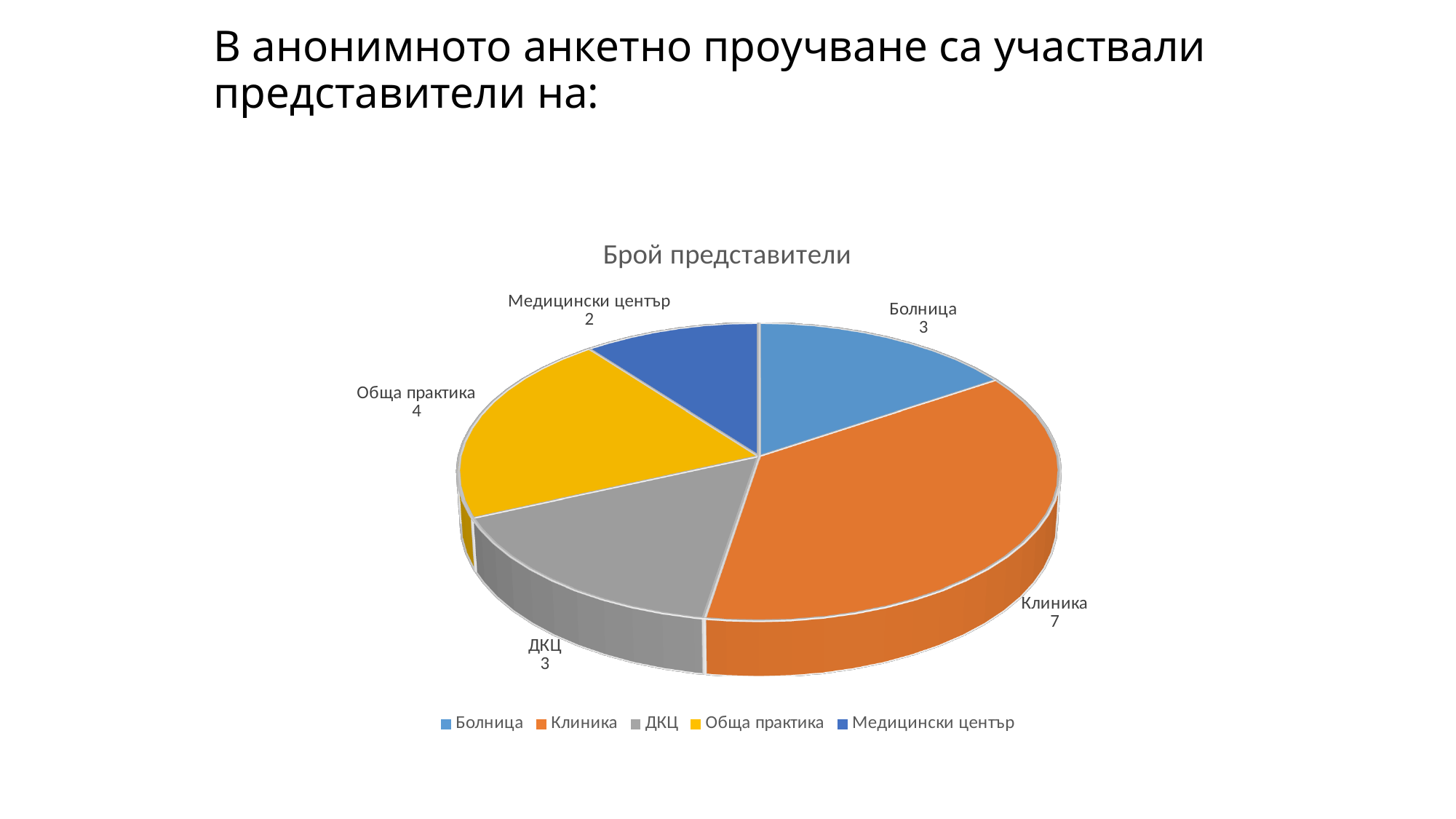
Which category has the highest value? Клиника What is the difference between the values for Клиника and Обща практика? 3 What is the total of all the values in the pie chart? 19 Which category is shown in yellow in the legend? Обща практика How many categories does the pie chart have? 5 What is the value for Медицински център? 2 What is the title of the chart? Брой представители Which category has the lowest value? Медицински център What is the value for Клиника? 7 What kind of chart is shown on the slide? pie chart Which is larger, the value for Обща практика or the value for Болница? Обща практика What is the value for Обща практика? 4